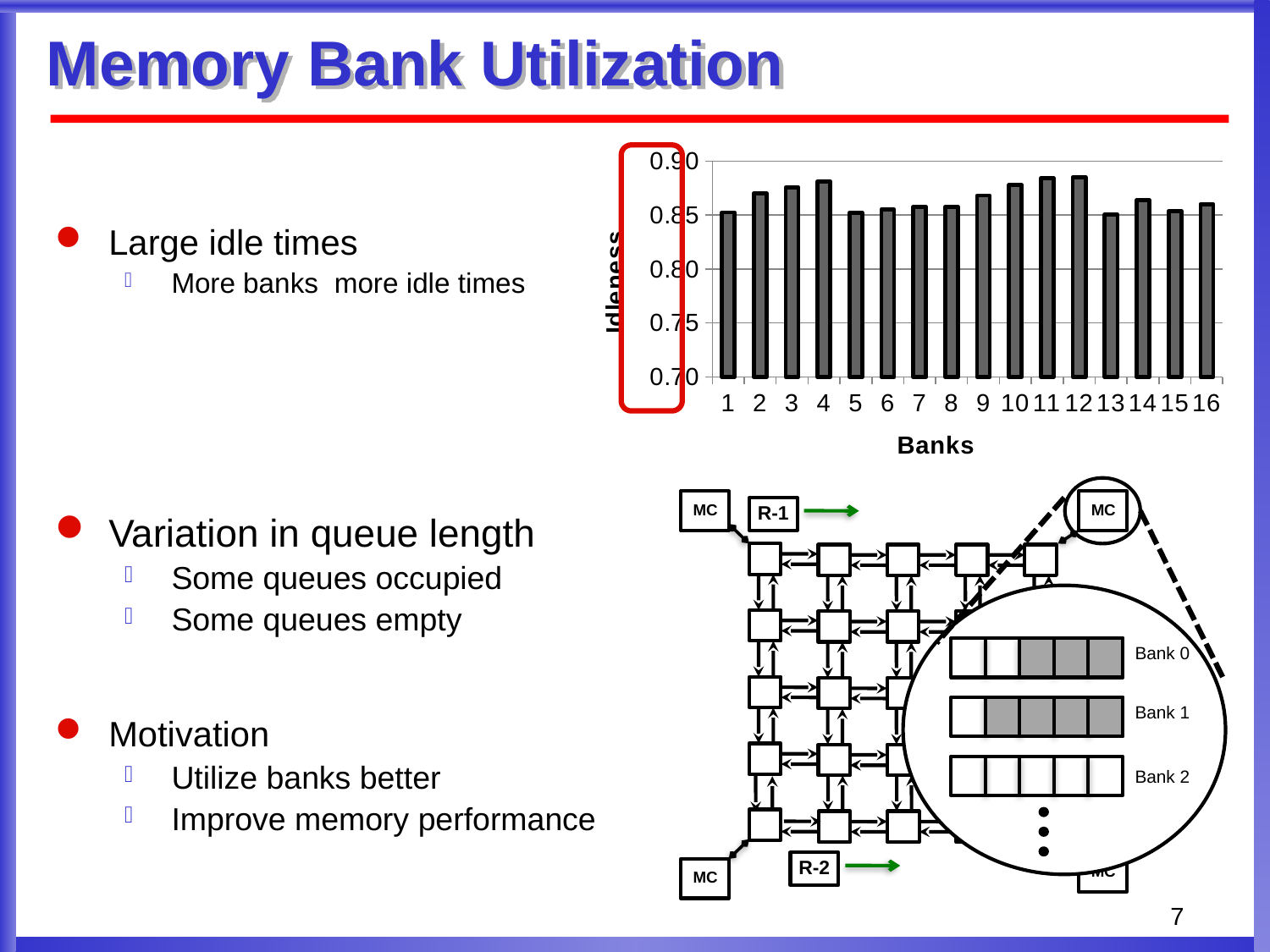
Is the idleness value for bank 4 greater or less than 0.85? greater Is the idleness value for bank 11 greater or less than 0.85? greater Are all the bars in the chart above 0.80 on the idleness axis? yes What is the title of the x axis of the chart? Banks Which has the higher idleness value, bank 11 or bank 13? bank 11 How many banks are plotted on the x axis of the chart? 16 What kind of chart is shown on the slide? bar chart Which has the higher idleness value, bank 4 or bank 5? bank 4 Which has the higher idleness value, bank 10 or bank 1? bank 10 What is the title of the y axis of the chart? Idleness